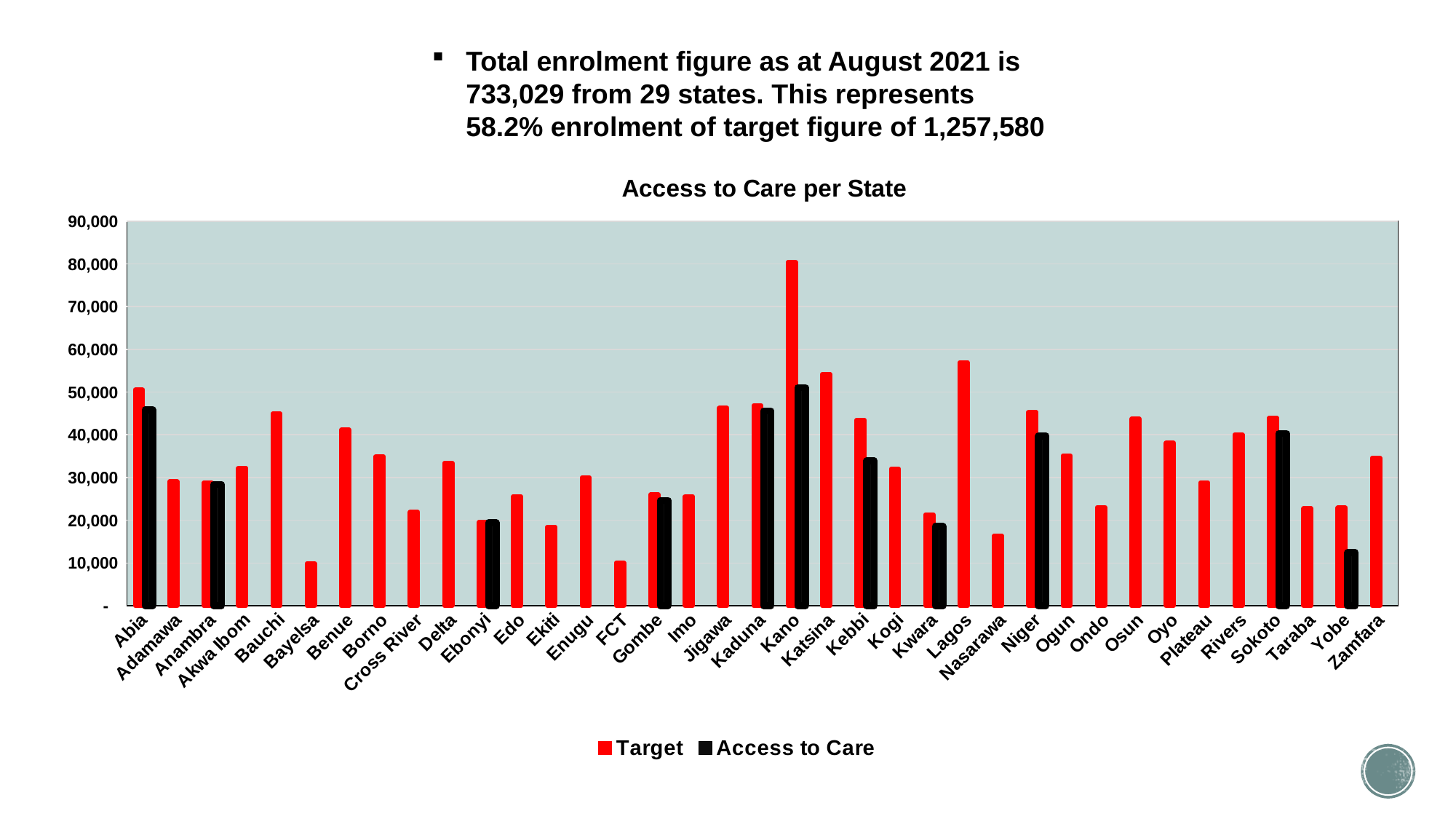
Which is larger, the Target value for Kano or the Target value for Lagos? Kano Is the Target value for Kano greater or less than 70,000? greater What is the title of the chart? Access to Care per State How many states are shown on the x axis of the chart? 37 Is the Target value for Lagos greater or less than 50,000? greater How many series does the legend list? 2 What kind of chart is shown on the slide? bar chart Is the Access to Care value for Kebbi greater or less than 40,000? less Which state has the highest Access to Care value? Kano Which state has the lowest Access to Care value among those with an Access to Care bar? Yobe Which state has the highest Target value? Kano